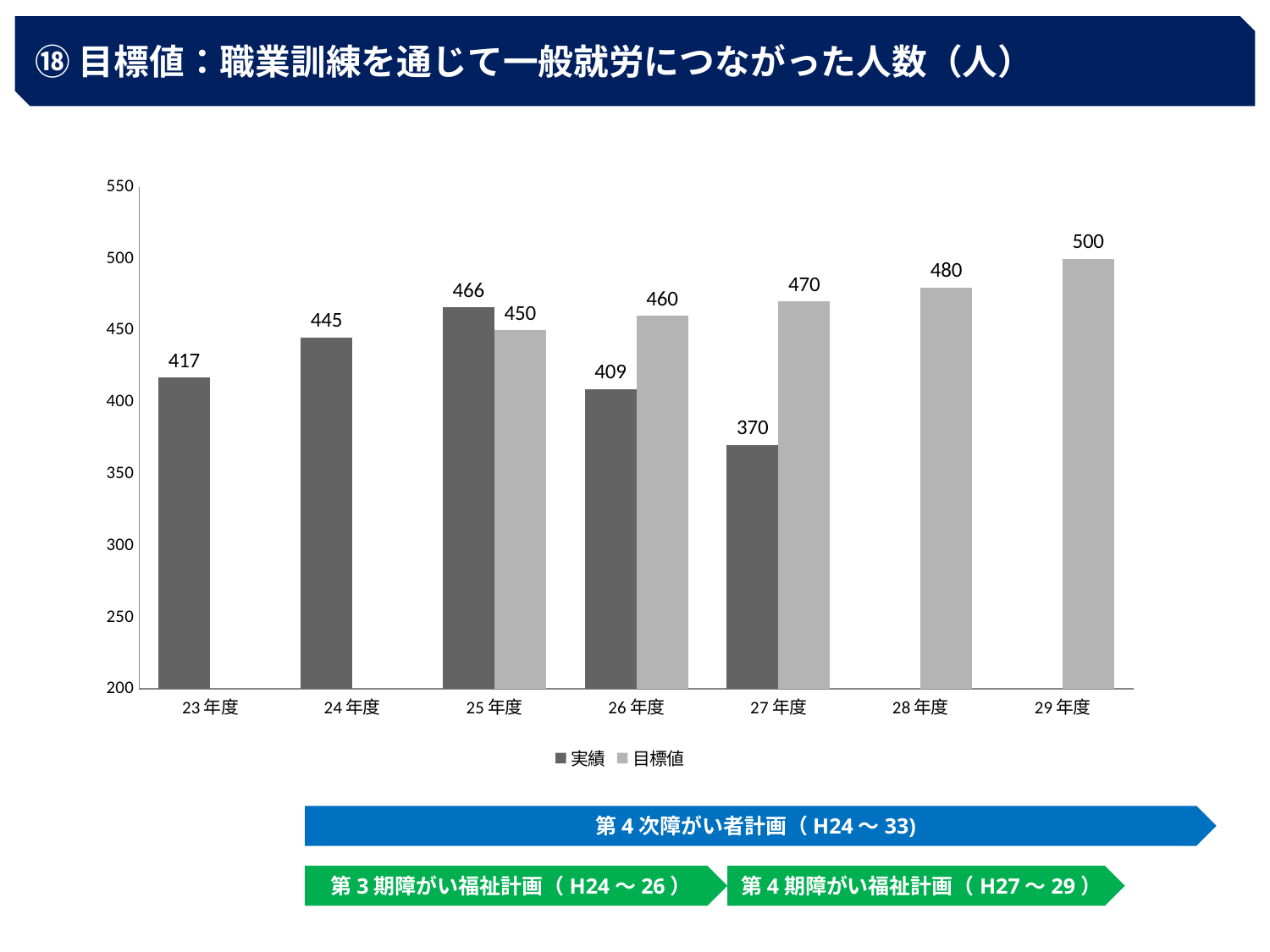
Which year has the highest 実績 value? 25年度 What is the difference between the 目標値 and 実績 values for 27年度? 100 What kind of chart is shown on the slide? Bar chart How many year categories are shown on the x axis? 7 Do the 目標値 values rise or fall from 25年度 to 29年度? Rise Which year has the lowest 実績 value? 27年度 What is the 実績 value for 23年度? 417 What is the 目標値 value for 29年度? 500 What is the 実績 value for 27年度? 370 Which is larger for 25年度, the 実績 value or the 目標値 value? 実績 Is the 目標値 value for 28年度 greater or less than 450? greater How many series does the legend list? 2